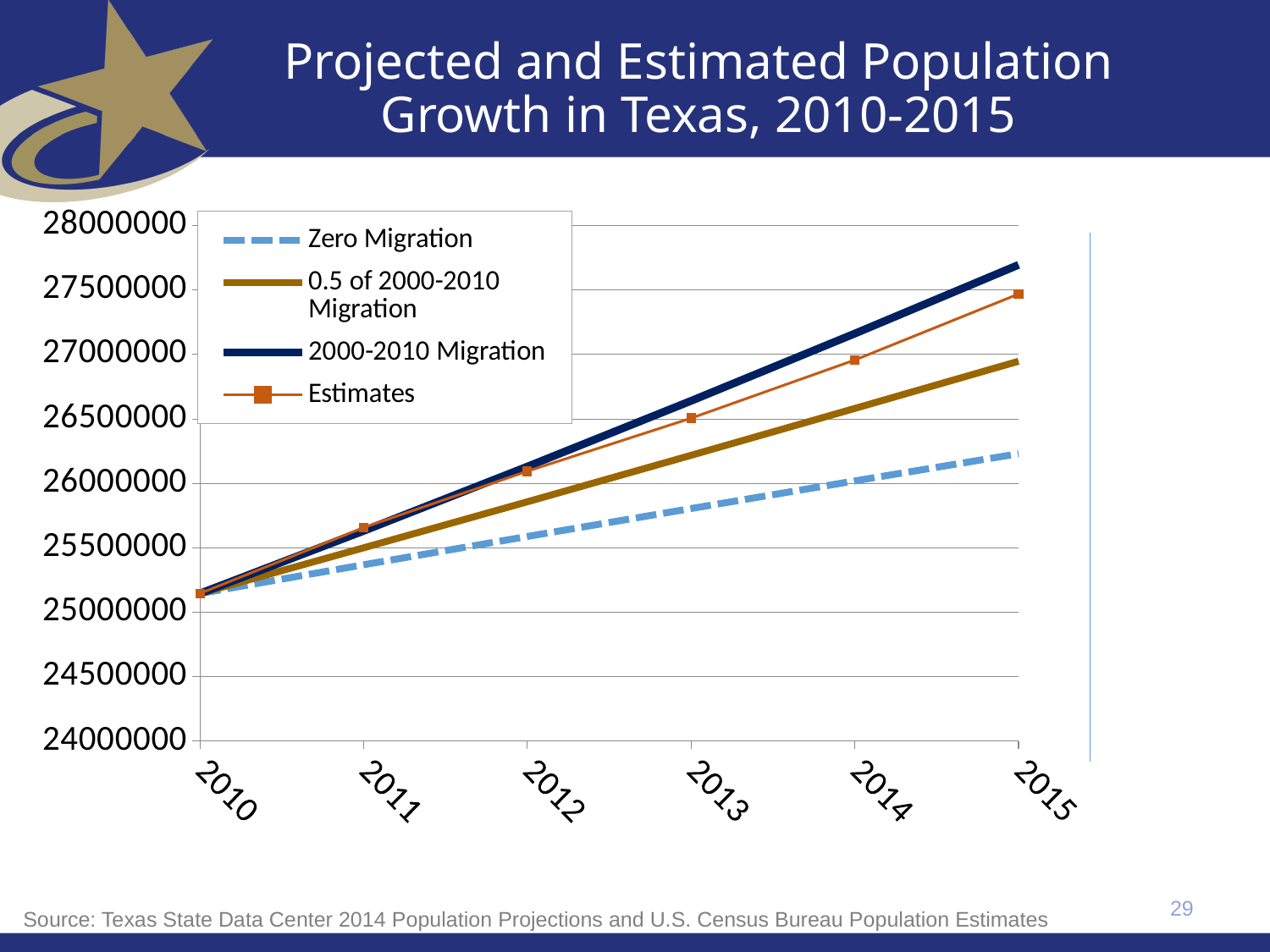
How many series does the legend list? 4 Which series has the lowest value in 2015? Zero Migration Is the value for Zero Migration in 2015 greater or less than 26000000? greater Do the values for the 2000-2010 Migration series rise or fall from 2010 to 2015? Rise Is the value for 2000-2010 Migration in 2015 greater or less than 27500000? greater What is the title of the chart? Projected and Estimated Population Growth in Texas, 2010-2015 How many years are shown along the x axis? 6 What kind of chart is shown on the slide? Line chart Which series is drawn with a dashed line? Zero Migration Which series has the highest value in 2015? 2000-2010 Migration Is the value for 0.5 of 2000-2010 Migration in 2013 greater or less than 26000000? greater In 2014, which is larger: the Estimates value or the 0.5 of 2000-2010 Migration value? Estimates